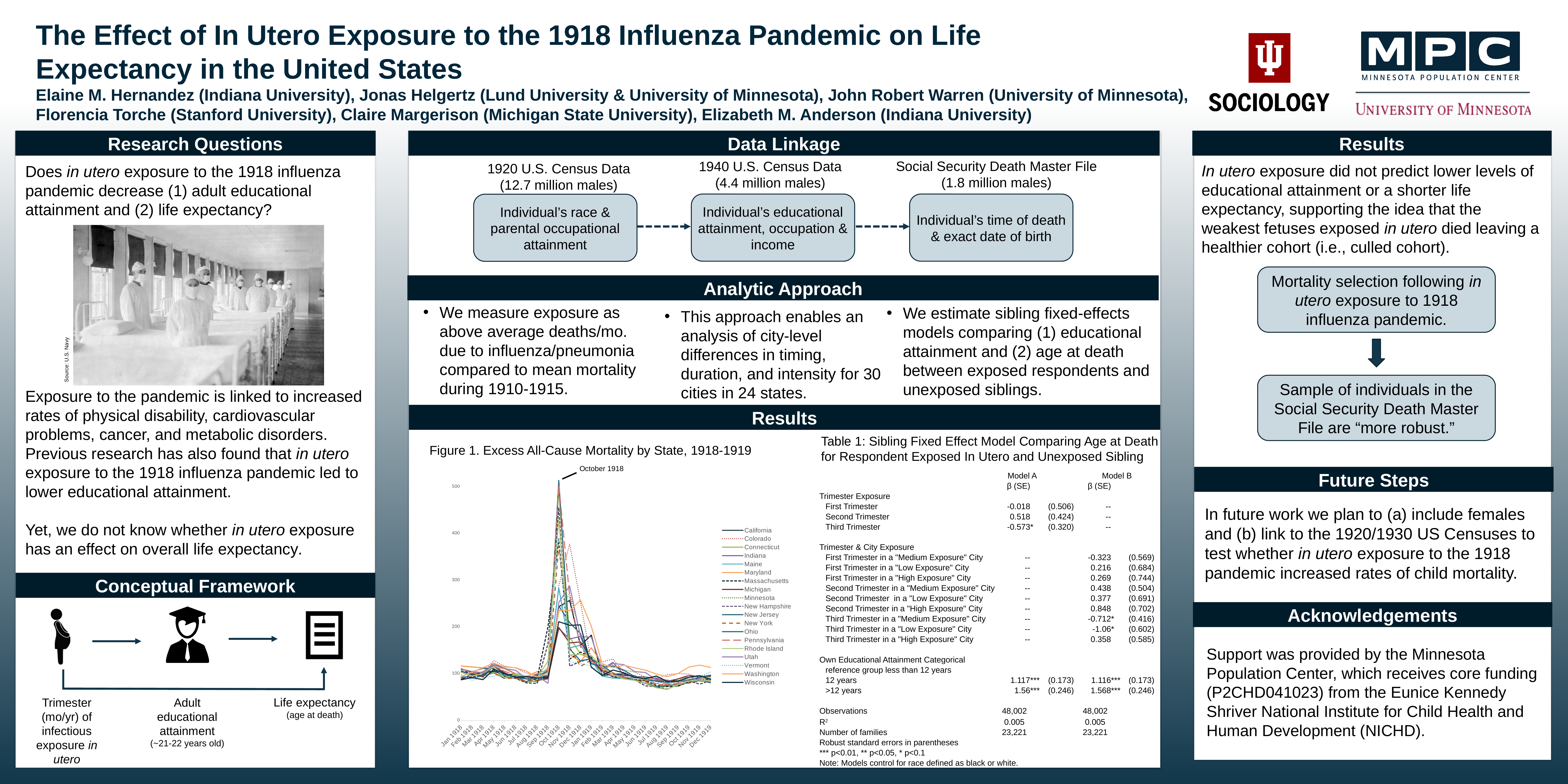
What is the title of the chart on the slide? Figure 1. Excess All-Cause Mortality by State, 1918-1919 In Figure 1, is the highest peak value in October 1918 greater or less than 400? greater In Figure 1, do the values rise or fall between August 1918 and October 1918? rise In which month does excess mortality peak in Figure 1? October 1918 In Figure 1, do the values rise or fall between October 1918 and December 1918? fall What kind of chart is Figure 1, Excess All-Cause Mortality by State, 1918-1919? line chart Which state is listed first in the legend of Figure 1? California How many states (series) does the legend of Figure 1 list? 19 How many months are shown along the x axis of Figure 1? 24 In Figure 1, are the values for the states in Jan 1918 greater or less than 200? less